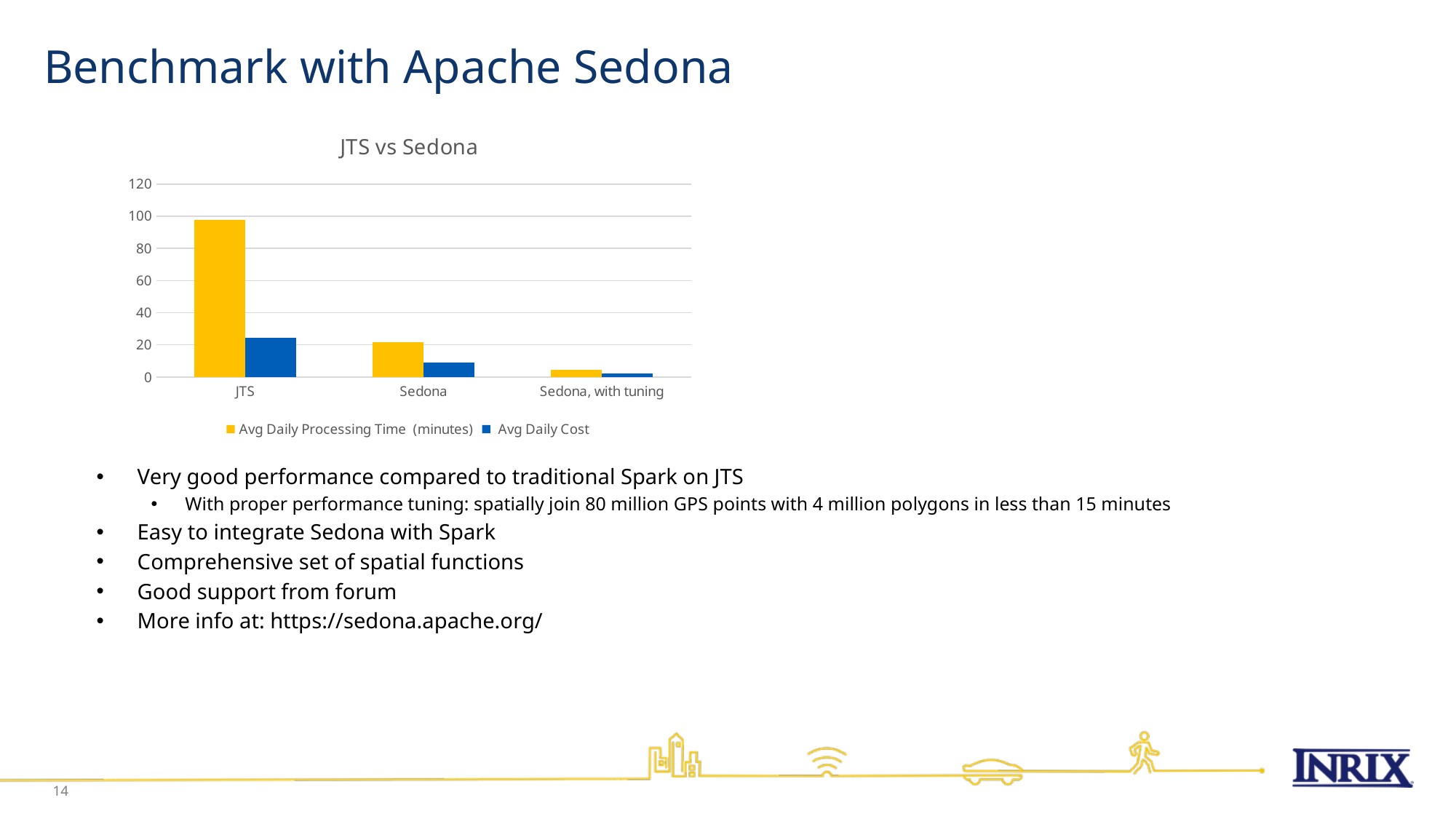
Is the Avg Daily Processing Time (minutes) for Sedona, with tuning greater or less than 20? less Which category has the highest Avg Daily Processing Time (minutes)? JTS Is the Avg Daily Processing Time (minutes) for Sedona greater or less than 40? less What type of chart is shown on the slide? bar chart What is the title of the chart? JTS vs Sedona Is the Avg Daily Cost for JTS greater or less than 40? less How many series does the chart legend list? 2 Do the Avg Daily Processing Time (minutes) values rise or fall from JTS to Sedona, with tuning? fall For JTS, which is larger: Avg Daily Processing Time (minutes) or Avg Daily Cost? Avg Daily Processing Time (minutes) How many categories are shown on the x axis of the chart? 3 Which category has the lowest Avg Daily Cost? Sedona, with tuning